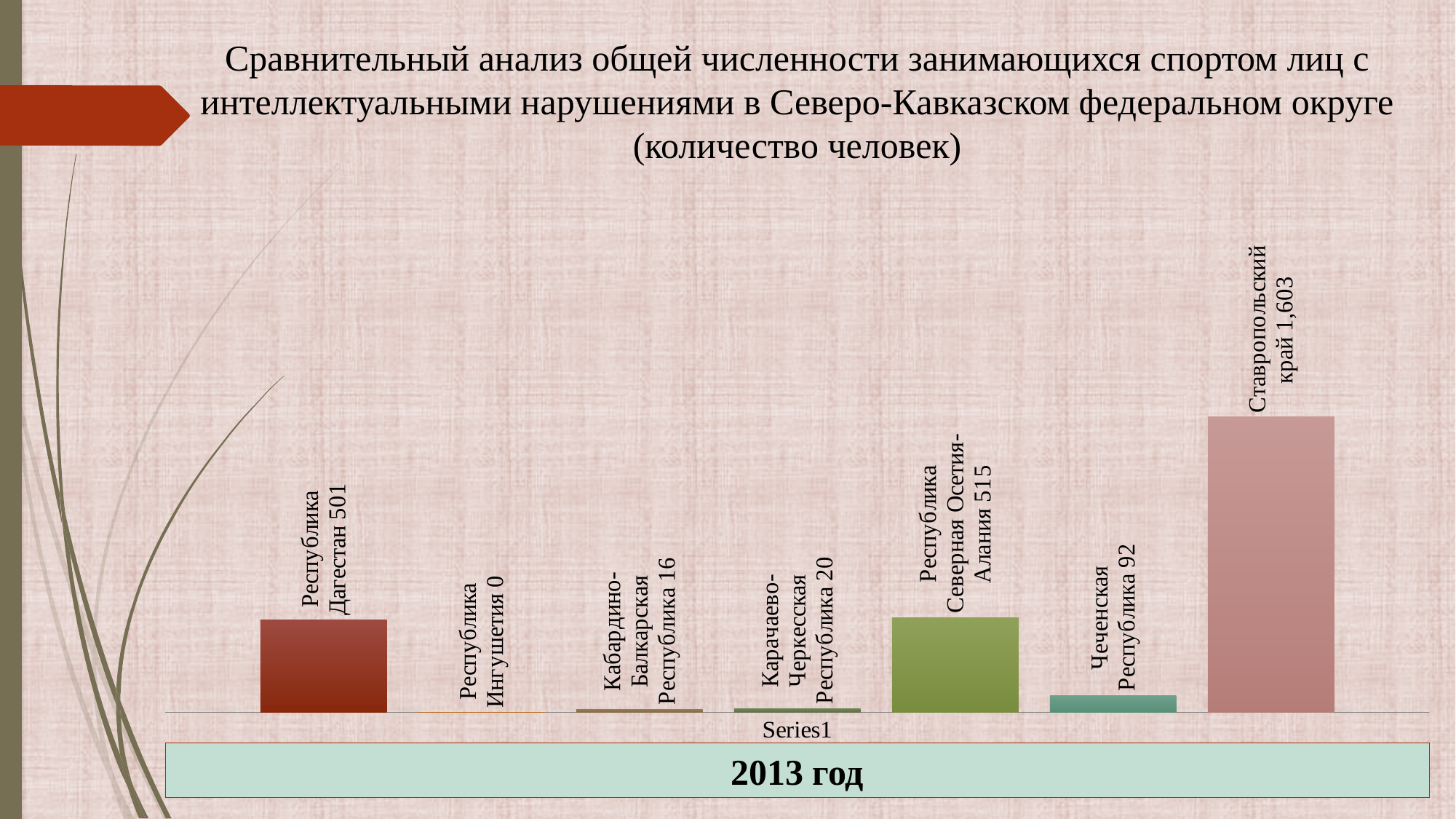
What is the value for Кабардино-Балкарская Республика? 16 What kind of chart is shown on the slide? bar chart Which is larger, the value for Республика Дагестан or the value for Чеченская Республика? Республика Дагестан What is the value for Ставропольский край? 1,603 What is the difference between the values for Ставропольский край and Республика Северная Осетия-Алания? 1,088 What is the value for Республика Дагестан? 501 How many regions are shown in the chart? 7 What is the value for Чеченская Республика? 92 What is the difference between the values for Карачаево-Черкесская Республика and Кабардино-Балкарская Республика? 4 Which region has the highest value? Ставропольский край Which year does the chart refer to, according to the label below it? 2013 год Which region has the lowest value? Республика Ингушетия